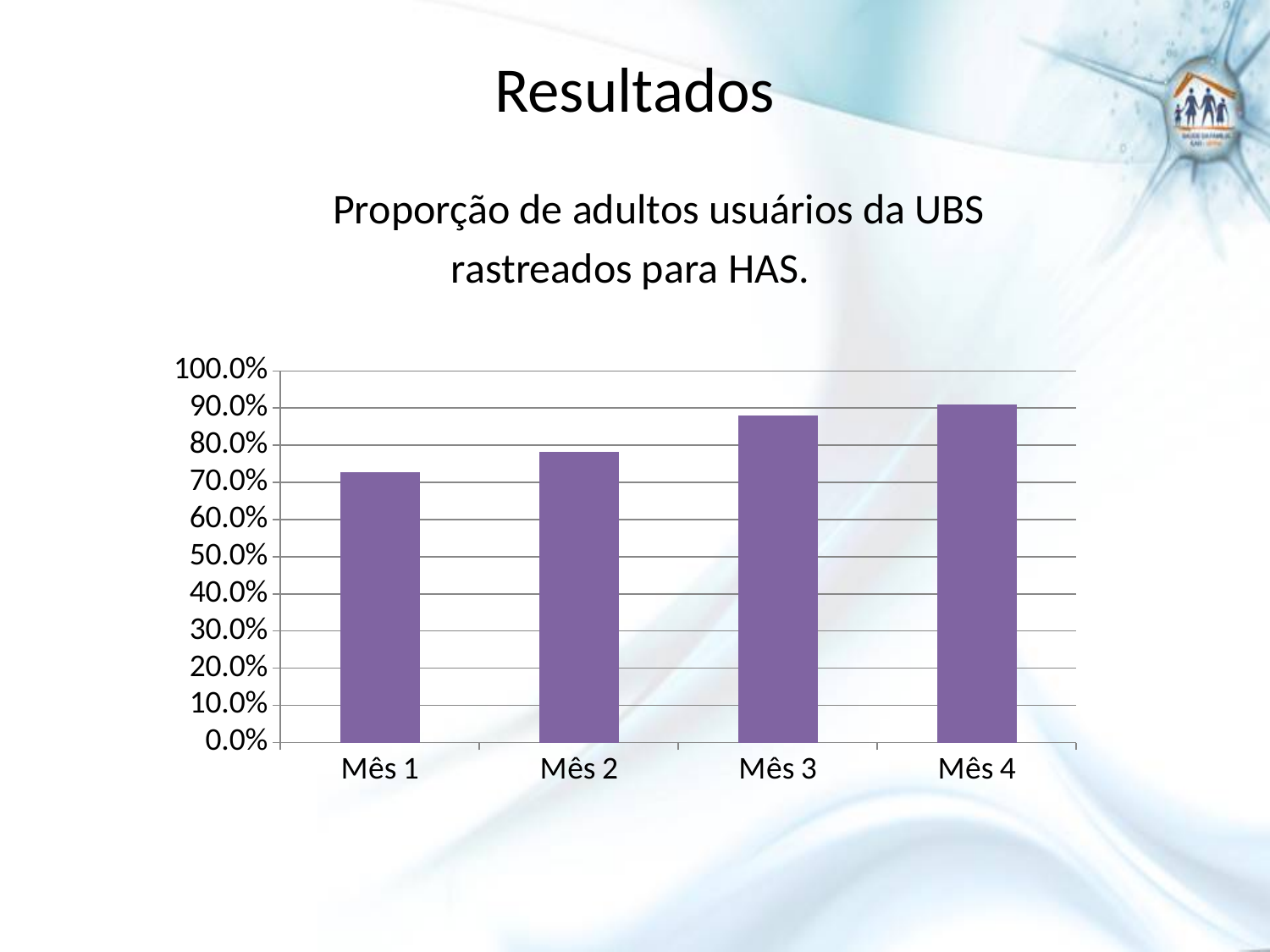
What colour are the bars in the chart? purple Which is larger, the value for Mês 1 or the value for Mês 3? Mês 3 Is the value for Mês 1 greater or less than 80.0%? less Is the value for Mês 3 greater or less than 80.0%? greater Is the value for Mês 4 greater or less than 80.0%? greater What kind of chart is shown on the slide? bar chart Which month has the lowest proportion of adults screened for HAS? Mês 1 What is the title of the chart? Proporção de adultos usuários da UBS rastreados para HAS. How many months (categories) are shown on the x axis of the chart? 4 Which month has the highest proportion of adults screened for HAS? Mês 4 Do the values rise or fall from Mês 1 to Mês 4? rise